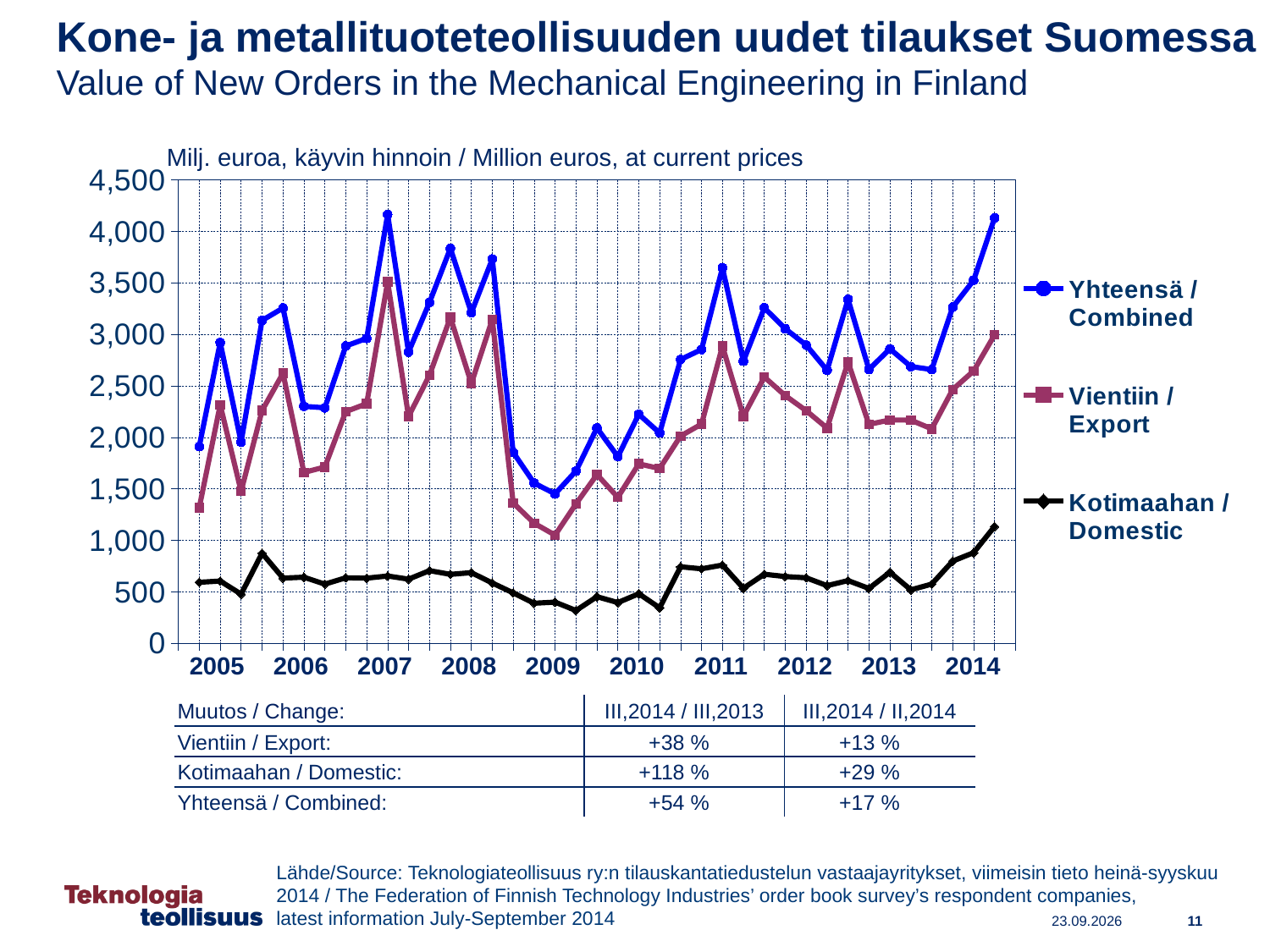
Which series has the highest values throughout the chart? Yhteensä / Combined How many year labels are shown on the x axis? 10 Is the peak value of the Yhteensä / Combined series in 2007 greater or less than 4,000? greater Is the last plotted value of the Kotimaahan / Domestic series in 2014 greater or less than 1,000? greater Which series is plotted with the blue line with circle markers? Yhteensä / Combined Is the first plotted value of the Yhteensä / Combined series in 2005 greater or less than 2,000? less How many series does the chart legend list? 3 Does the Yhteensä / Combined series rise or fall from 2013 to the end of 2014? rise What unit is stated above the chart for the plotted values? Milj. euroa, käyvin hinnoin / Million euros, at current prices What kind of chart is shown on the slide? line chart Which is larger at the end of 2014, the Vientiin / Export value or the Kotimaahan / Domestic value? Vientiin / Export Which series has the lowest values throughout the chart? Kotimaahan / Domestic